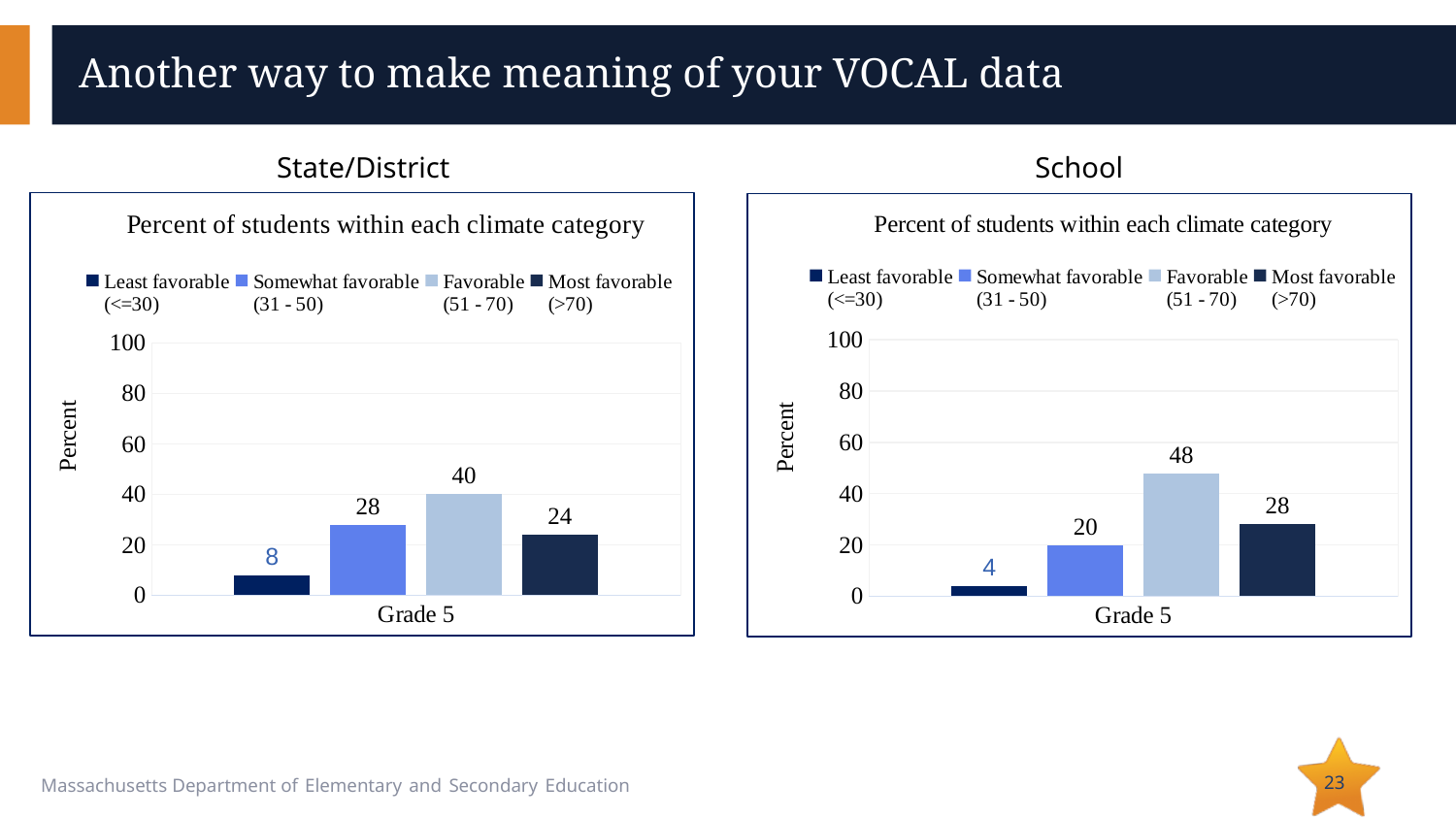
In the School chart, what is the difference between the Favorable (51 - 70) value and the Least favorable (<=30) value? 44 In the State/District chart, what is the value for Least favorable (<=30) for Grade 5? 8 In the State/District chart, which is larger: Somewhat favorable (31 - 50) or Most favorable (>70)? Somewhat favorable (31 - 50) What is the title of the School chart? Percent of students within each climate category In the School chart, which climate category has the highest value? Favorable (51 - 70) In the School chart, what is the value for Most favorable (>70) for Grade 5? 28 In the State/District chart, which climate category has the lowest value? Least favorable (<=30) How many series does the legend of the School chart list? 4 In the State/District chart, is the value for Favorable (51 - 70) greater or less than 20? greater What kind of chart is the State/District chart? bar chart In the State/District chart, what is the value for Favorable (51 - 70) for Grade 5? 40 In the School chart, what is the value for Somewhat favorable (31 - 50) for Grade 5? 20